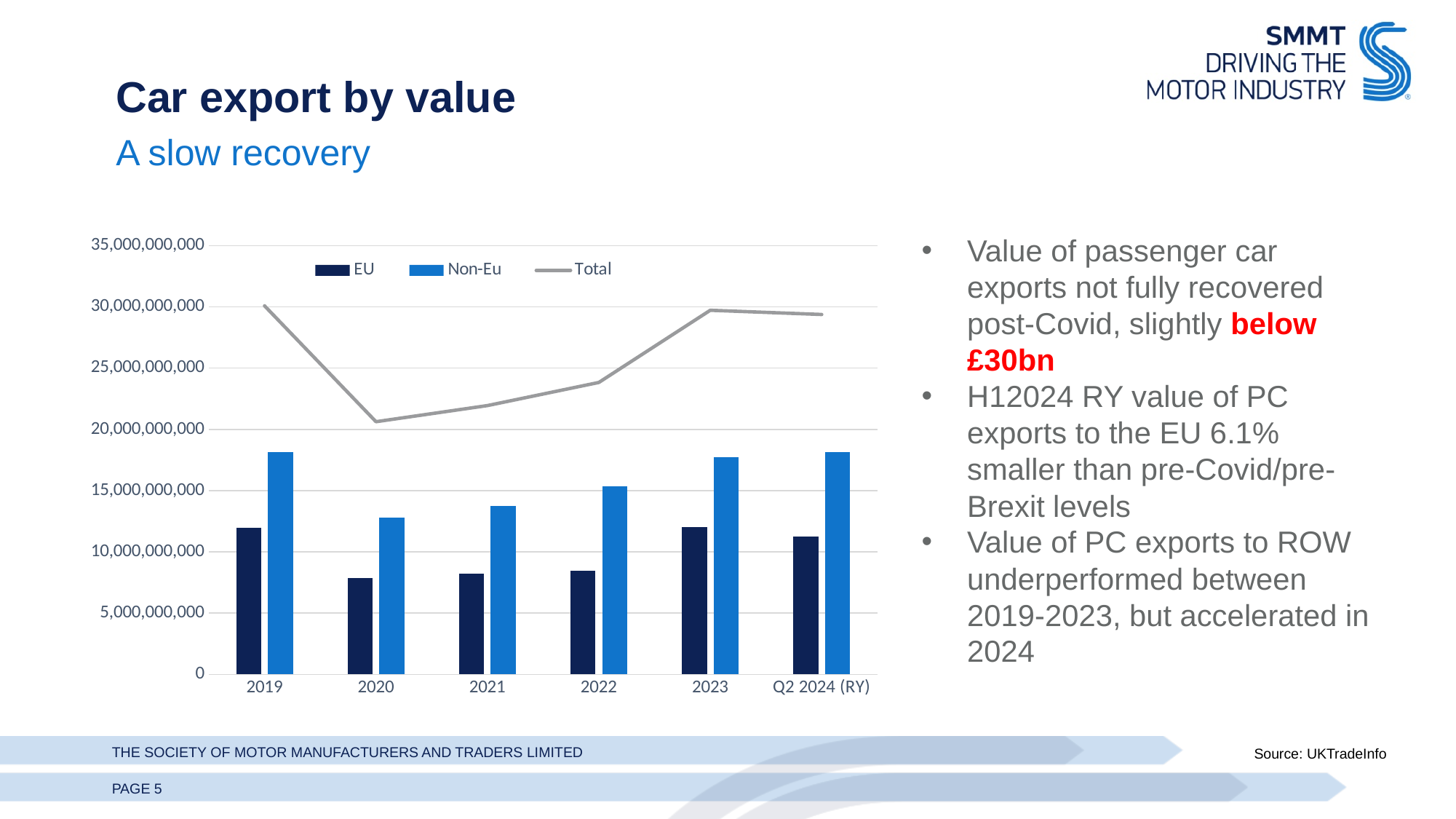
How many series does the chart legend list? 3 Is the EU value for 2022 greater or less than 10,000,000,000? less Is the Non-Eu value for 2020 greater or less than 15,000,000,000? less In which year is the Non-Eu value lowest? 2020 Which is larger: the Total value for 2019 or the Total value for 2022? 2019 In 2021, which is larger: the EU value or the Non-Eu value? Non-Eu How many time periods are shown on the x axis of the chart? 6 Which series in the chart is drawn as a line rather than bars? Total In which year is the Total line at its lowest point? 2020 Is the Total value for 2022 greater or less than 25,000,000,000? less Does the Non-Eu value rise or fall from 2020 to 2023? rise